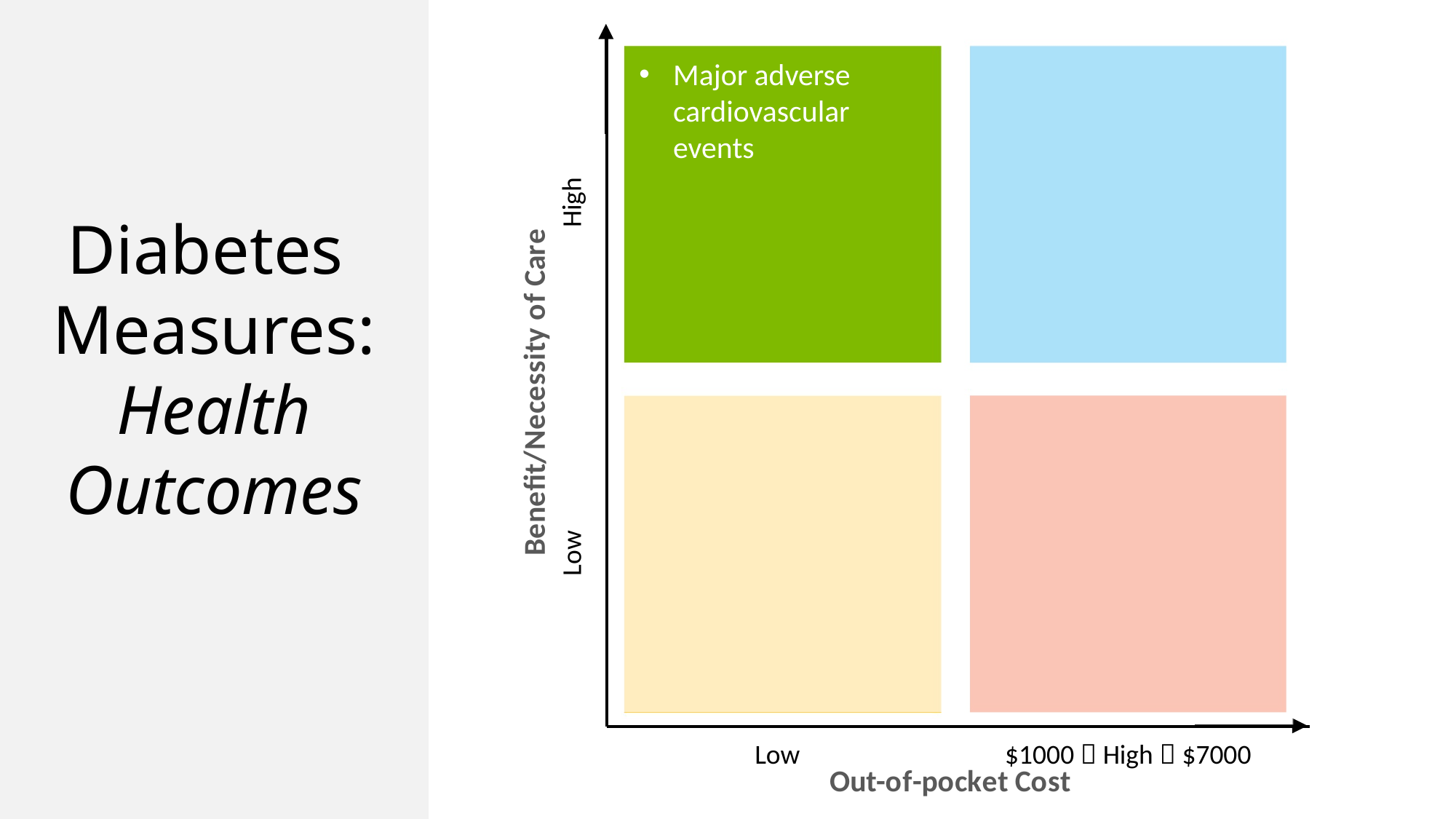
How many quadrants does the chart have? 4 Is the out-of-pocket cost for 'Major adverse cardiovascular events' high or low? Low How many items are placed in the quadrant chart? 1 What is the label of the vertical axis of the quadrant chart? Benefit/Necessity of Care What dollar range is given for 'High' out-of-pocket cost on the horizontal axis? $1000 to $7000 In which quadrant is 'Major adverse cardiovascular events' placed? High benefit/necessity of care, low out-of-pocket cost (top left) Is the benefit/necessity of care for 'Major adverse cardiovascular events' high or low? High What is the label of the horizontal axis of the quadrant chart? Out-of-pocket Cost What kind of chart is shown on the slide? A 2x2 quadrant matrix